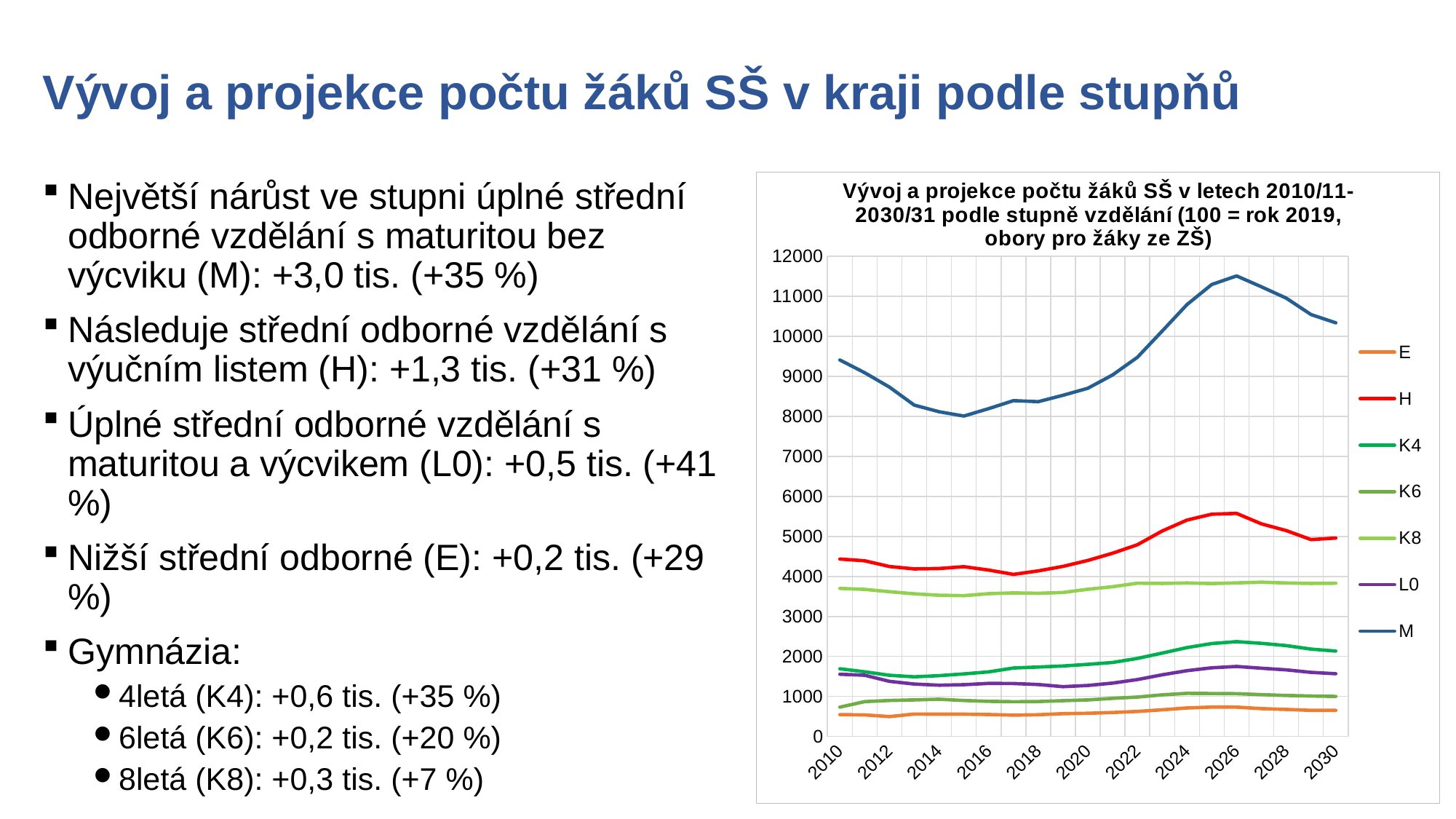
Is the value for series M in 2026 greater or less than 11000? greater In 2030, which series has the larger value, K4 or L0? K4 Which series has the highest values throughout the chart? M What colour is the line for series H in the chart? red What kind of chart is shown on the slide? line chart Does the value for series H rise or fall between 2026 and 2030? fall Is the value for series H in 2026 greater or less than 5000? greater Is the value for series K8 in 2010 greater or less than 4000? less Which series has the lowest values throughout the chart? E Does the value for series M rise or fall between 2018 and 2026? rise How many series does the chart legend list? 7